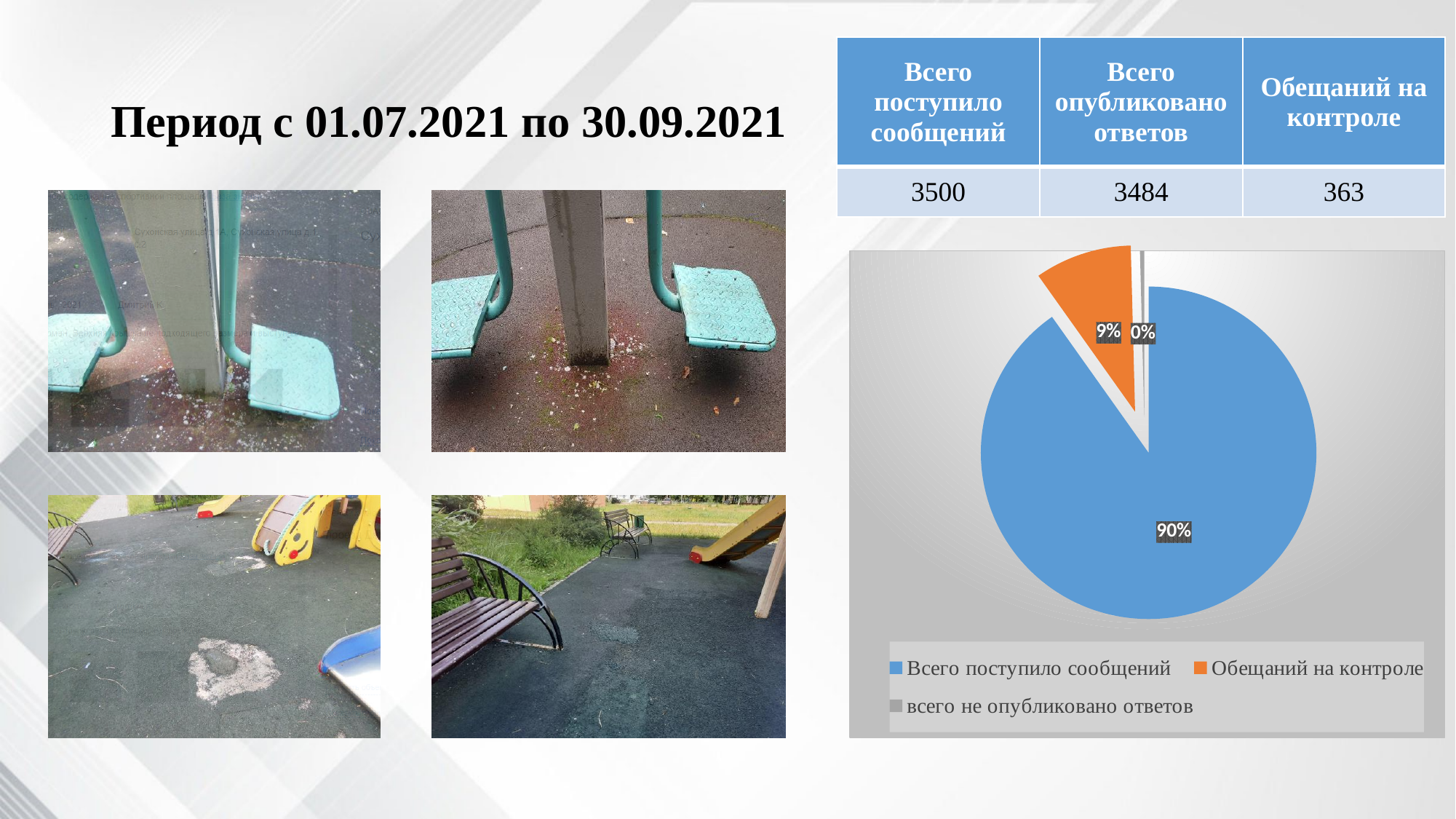
What kind of chart is shown on the slide? pie chart What share of the pie does "всего не опубликовано ответов" take? 0% Which is larger in the pie chart: "Обещаний на контроле" or "всего не опубликовано ответов"? Обещаний на контроле What share of the pie does "Обещаний на контроле" take? 9% By how many percentage points does the "Всего поступило сообщений" slice exceed the "Обещаний на контроле" slice? 81 What share of the pie does "Всего поступило сообщений" take? 90% Which slice of the pie chart is the largest? Всего поступило сообщений How many slices does the pie chart have? 3 How many entries does the legend of the pie chart list? 3 What colour is the "Всего поступило сообщений" slice in the pie chart? blue What colour is the "Обещаний на контроле" slice in the pie chart? orange Which slice of the pie chart is the smallest? всего не опубликовано ответов